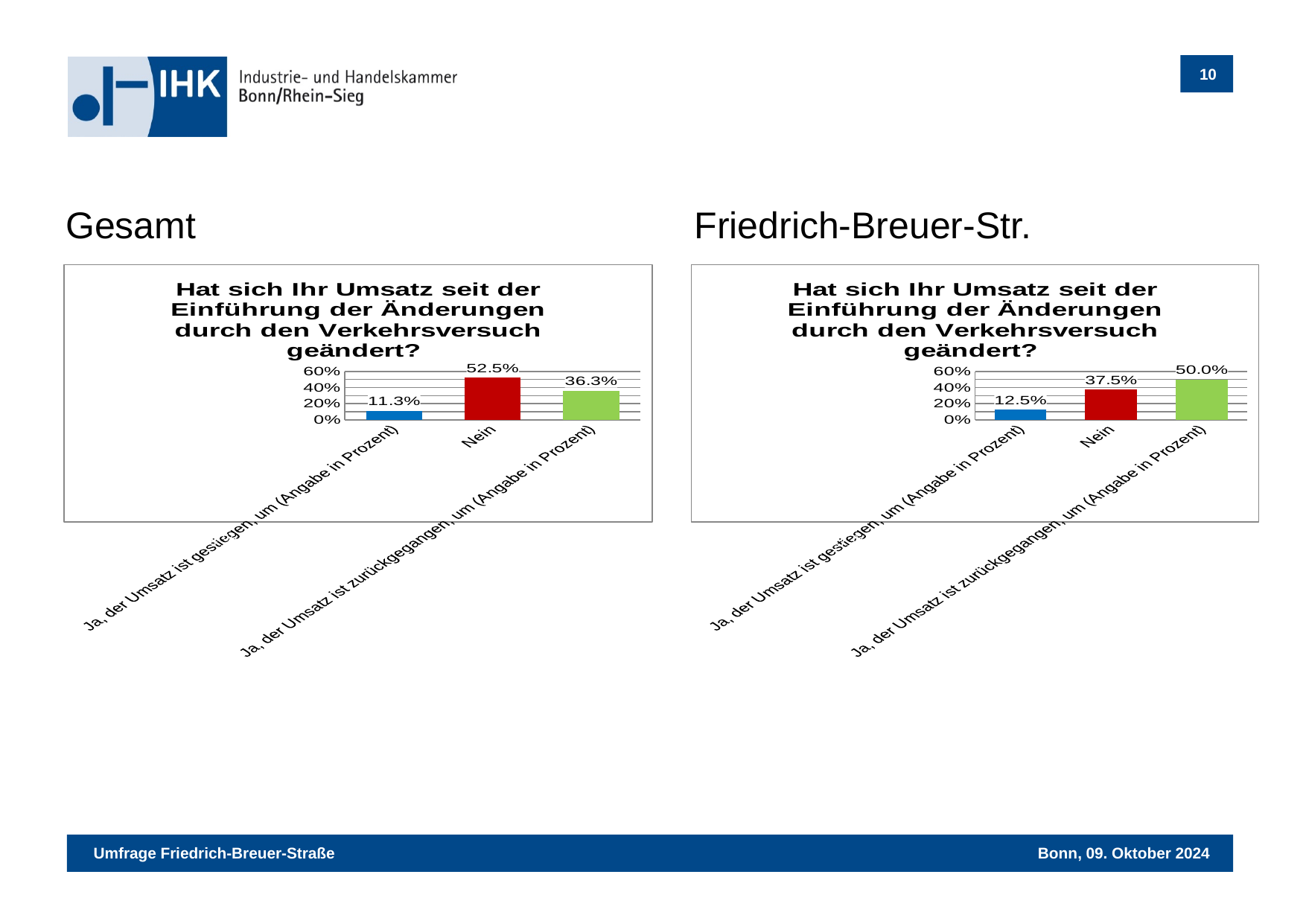
In the Friedrich-Breuer-Str. chart, which is larger: the value for "Nein" or the value for "Ja, der Umsatz ist zurückgegangen, um (Angabe in Prozent)"? Ja, der Umsatz ist zurückgegangen, um (Angabe in Prozent) In the Gesamt chart, what is the value for "Nein"? 52.5% In the Gesamt chart, what is the value for "Ja, der Umsatz ist gestiegen, um (Angabe in Prozent)"? 11.3% In the Friedrich-Breuer-Str. chart, what is the value for "Nein"? 37.5% In the Friedrich-Breuer-Str. chart, which category has the lowest value? Ja, der Umsatz ist gestiegen, um (Angabe in Prozent) In the Gesamt chart, what colour is the bar for "Nein"? Red How many categories does the Gesamt chart show? 3 What kind of chart is the Friedrich-Breuer-Str. chart? Bar chart In the Friedrich-Breuer-Str. chart, what is the value for "Ja, der Umsatz ist zurückgegangen, um (Angabe in Prozent)"? 50.0% In the Friedrich-Breuer-Str. chart, what is the difference between the values for "Ja, der Umsatz ist zurückgegangen, um (Angabe in Prozent)" and "Nein"? 12.5% In the Gesamt chart, what is the difference between the values for "Nein" and "Ja, der Umsatz ist zurückgegangen, um (Angabe in Prozent)"? 16.2% In the Gesamt chart, which category has the highest value? Nein